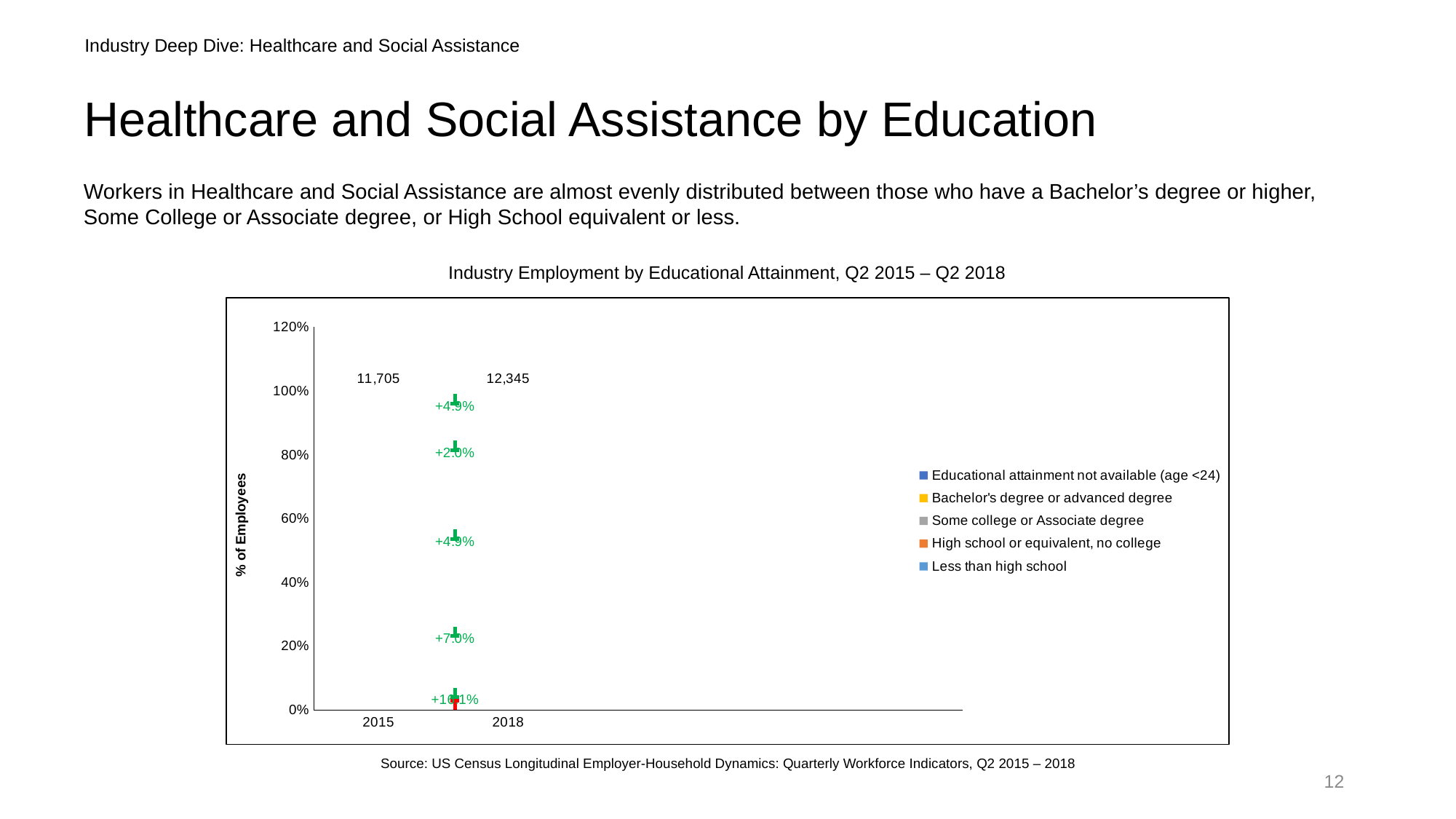
What is the title of the chart? Industry Employment by Educational Attainment, Q2 2015 – Q2 2018 Which year shows the highest total employment figure in the chart? 2018 What is the label on the y axis of the chart? % of Employees What total employment figure is printed above the 2015 bar? 11,705 How many series does the legend list in the chart? 5 What is the difference between the total employment figures printed for 2018 and 2015? 640 How many years are shown on the x axis of the chart? 2 Which year has the larger total employment figure printed above its bar, 2015 or 2018? 2018 What total employment figure is printed above the 2018 bar? 12,345